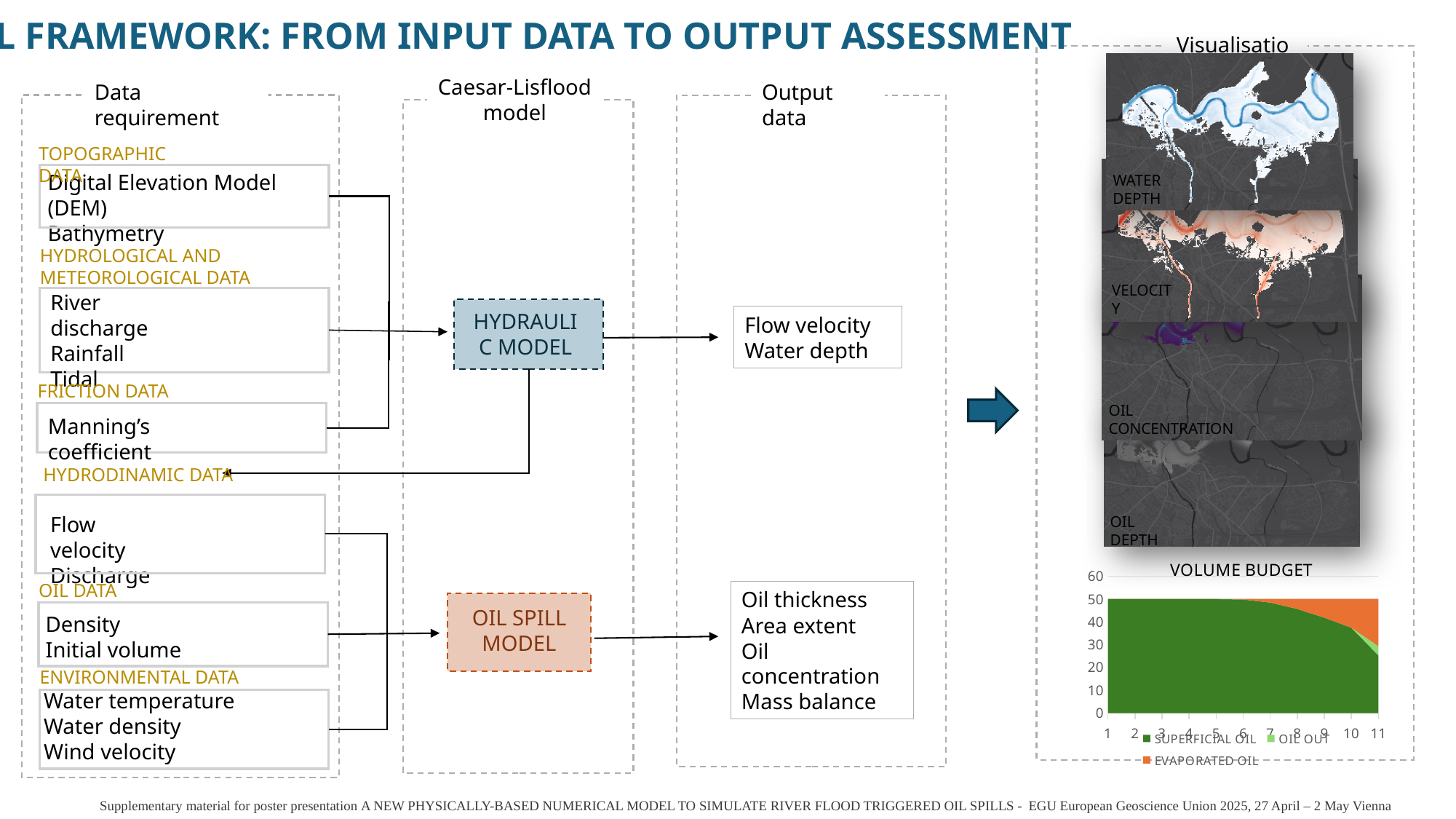
How many points are labelled along the x axis of the VOLUME BUDGET chart? 11 In the VOLUME BUDGET chart, does the EVAPORATED OIL series rise or fall along the x axis? rise In the VOLUME BUDGET chart, does the SUPERFICIAL OIL series rise or fall along the x axis? fall In the VOLUME BUDGET chart, is the value for SUPERFICIAL OIL at x = 1 greater or less than 40? greater In the VOLUME BUDGET chart, which series has the largest value at x = 11? SUPERFICIAL OIL In the VOLUME BUDGET chart, is the value for SUPERFICIAL OIL at x = 11 greater or less than 40? less Which series are listed in the legend of the VOLUME BUDGET chart? SUPERFICIAL OIL, OIL OUT, EVAPORATED OIL What kind of chart is the VOLUME BUDGET chart? stacked area chart How many series does the legend of the VOLUME BUDGET chart list? 3 In the VOLUME BUDGET chart, at x = 11, which is larger: SUPERFICIAL OIL or EVAPORATED OIL? SUPERFICIAL OIL What is the title of the chart on the slide? VOLUME BUDGET In the VOLUME BUDGET chart, which series has the smallest value at x = 11? OIL OUT